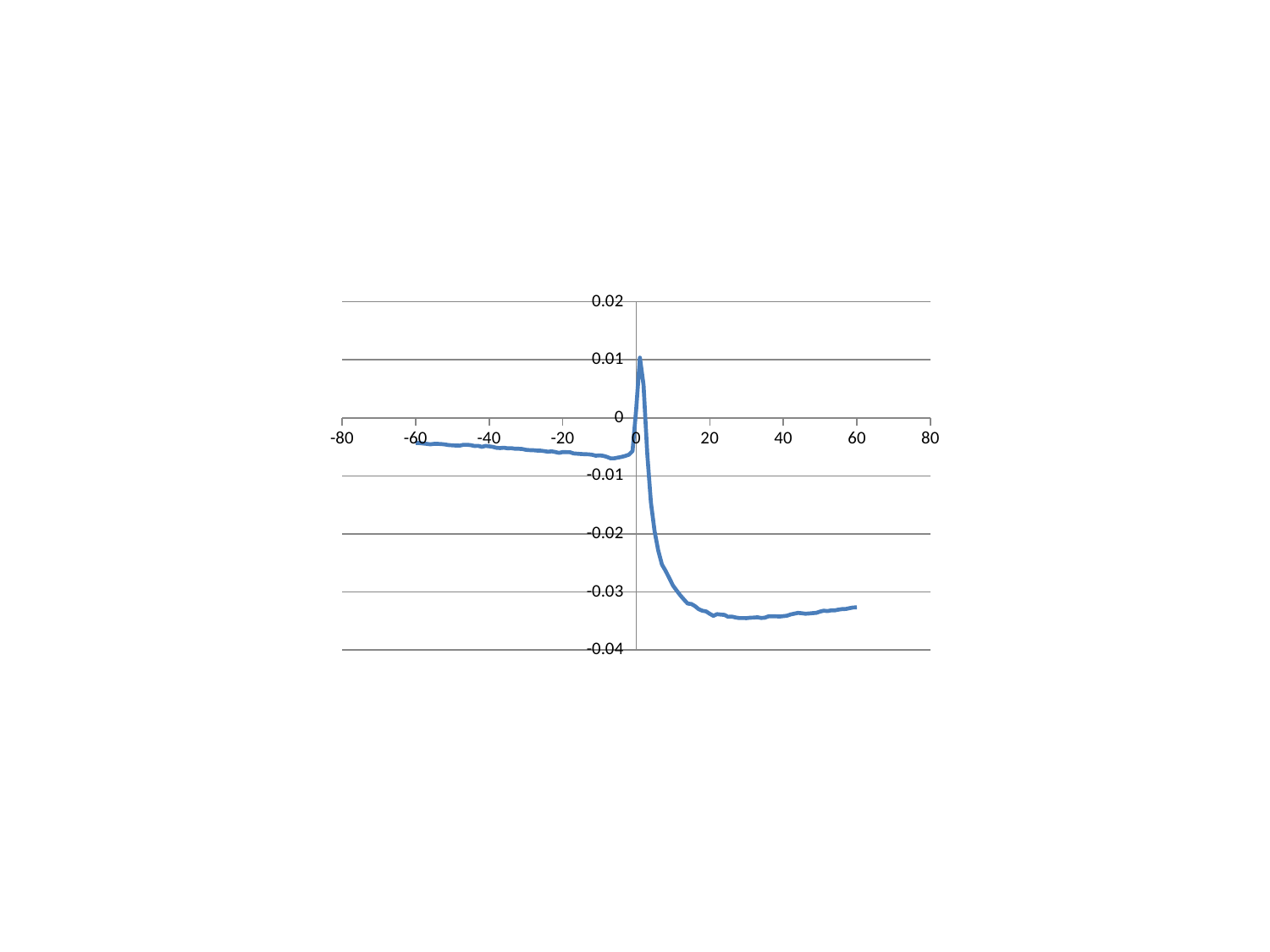
What kind of chart is shown on the slide? line chart Is the peak value of the line near x = 0 greater or less than 0? greater Near which x-axis tick does the line reach its highest point? 0 What is the lowest value labelled on the horizontal axis? -80 Is the value of the line at x = -60 greater or less than -0.01? greater Is the value of the line at x = 40 greater or less than -0.03? less What is the highest value labelled on the vertical axis? 0.02 Which is larger, the value of the line at x = -60 or at x = 60? x = -60 Do the values rise or fall as x increases from 0 to 20? fall Do the values rise or fall as x increases from 40 to 60? rise